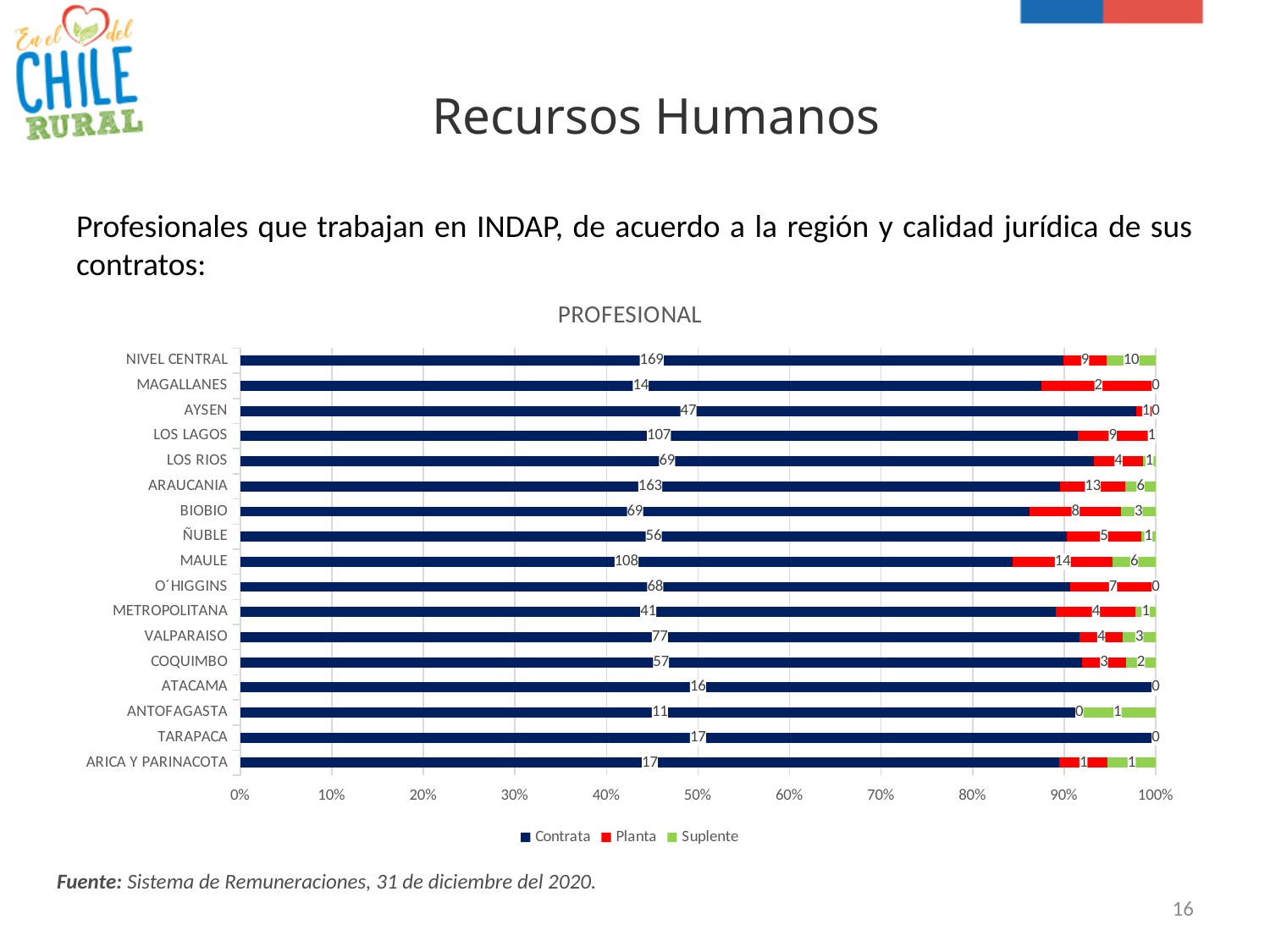
What is the difference between the Contrata values for NIVEL CENTRAL and ARAUCANIA? 6 What is the Suplente value for ARAUCANIA? 6 Which region has the lowest Contrata value? ANTOFAGASTA Which region has the highest Contrata value? NIVEL CENTRAL What is the Planta value for MAULE? 14 How many regions (categories) are shown on the chart? 17 What is the total number of professionals (Contrata + Planta + Suplente) for NIVEL CENTRAL? 188 What is the Contrata value for NIVEL CENTRAL? 169 How many series does the legend list? 3 Which has a larger Contrata value, MAULE or LOS LAGOS? MAULE What kind of chart is shown? Stacked bar chart What is the title of the chart? PROFESIONAL